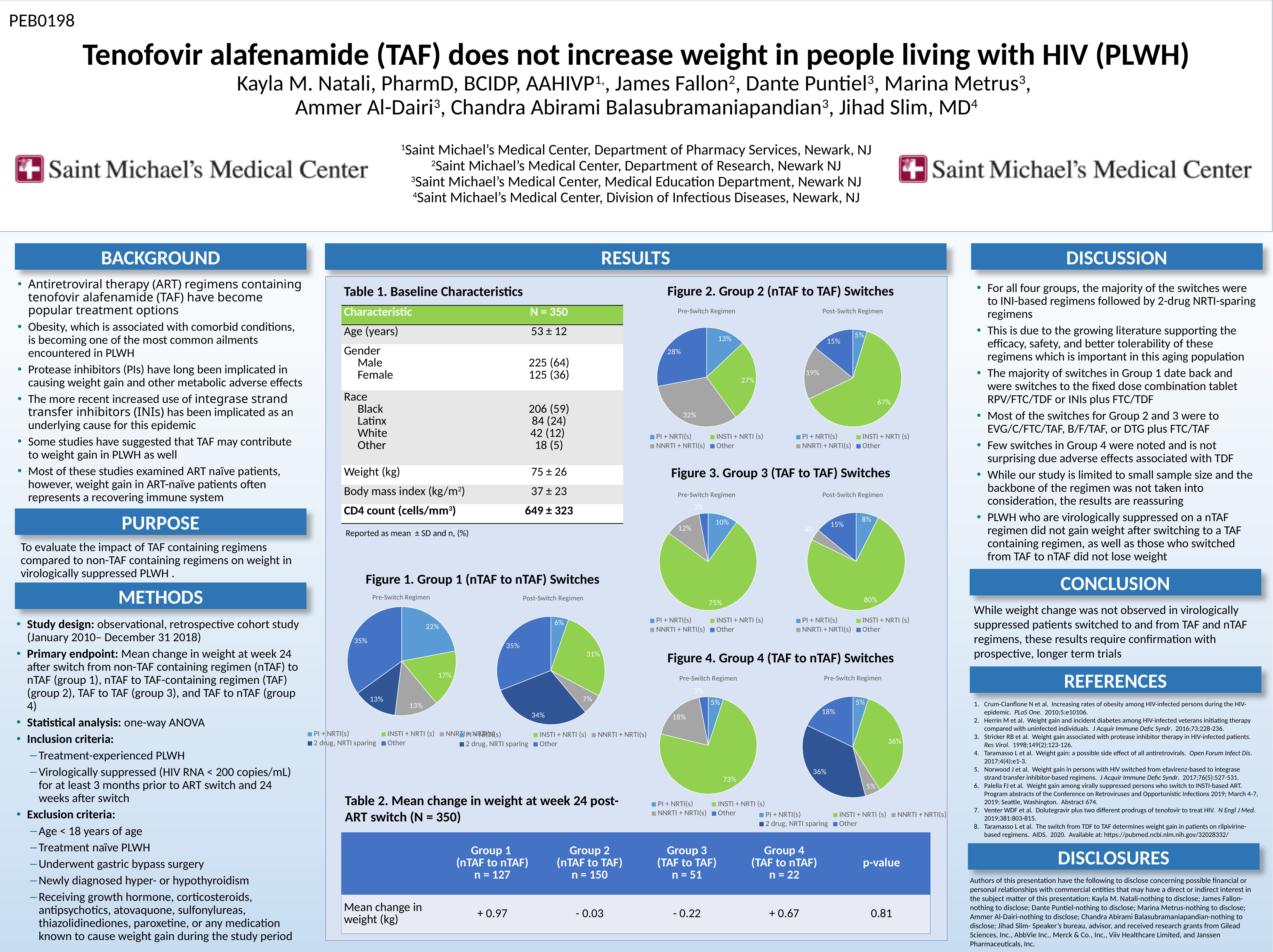
In Figure 3 (Group 3, TAF to TAF Switches), what percentage of the Post-Switch Regimen pie is INSTI + NRTI(s)? 80% In Figure 2 (Group 2, nTAF to TAF Switches), what percentage of the Pre-Switch Regimen pie is INSTI + NRTI(s)? 27% In Figure 1 (Group 1, nTAF to nTAF Switches), what percentage of the Pre-Switch Regimen pie is PI + NRTI(s)? 22% In Figure 4 (Group 4, TAF to nTAF Switches), what percentage of the Pre-Switch Regimen pie is NNRTI + NRTI(s)? 18% In Figure 2 (Group 2, nTAF to TAF Switches) Pre-Switch Regimen pie, which is larger: NNRTI + NRTI(s) or Other? NNRTI + NRTI(s) In Figure 3 (Group 3, TAF to TAF Switches), what percentage of the Pre-Switch Regimen pie is INSTI + NRTI(s)? 75% What type of chart is used in Figures 1 through 4 on this slide? Pie chart In Figure 1 (Group 1, nTAF to nTAF Switches), which category has the largest slice of the Pre-Switch Regimen pie? Other In Figure 2 (Group 2, nTAF to TAF Switches), which regimen category has the largest slice of the Post-Switch Regimen pie? INSTI + NRTI(s) In Figure 3 (Group 3, TAF to TAF Switches) Pre-Switch Regimen pie, what is the difference in percentage points between INSTI + NRTI(s) and NNRTI + NRTI(s)? 63 percentage points How many regimen categories does the legend of Figure 1 (Group 1, nTAF to nTAF Switches) list? 5 In Figure 2 (Group 2, nTAF to TAF Switches), what percentage of the Pre-Switch Regimen pie is NNRTI + NRTI(s)? 32%